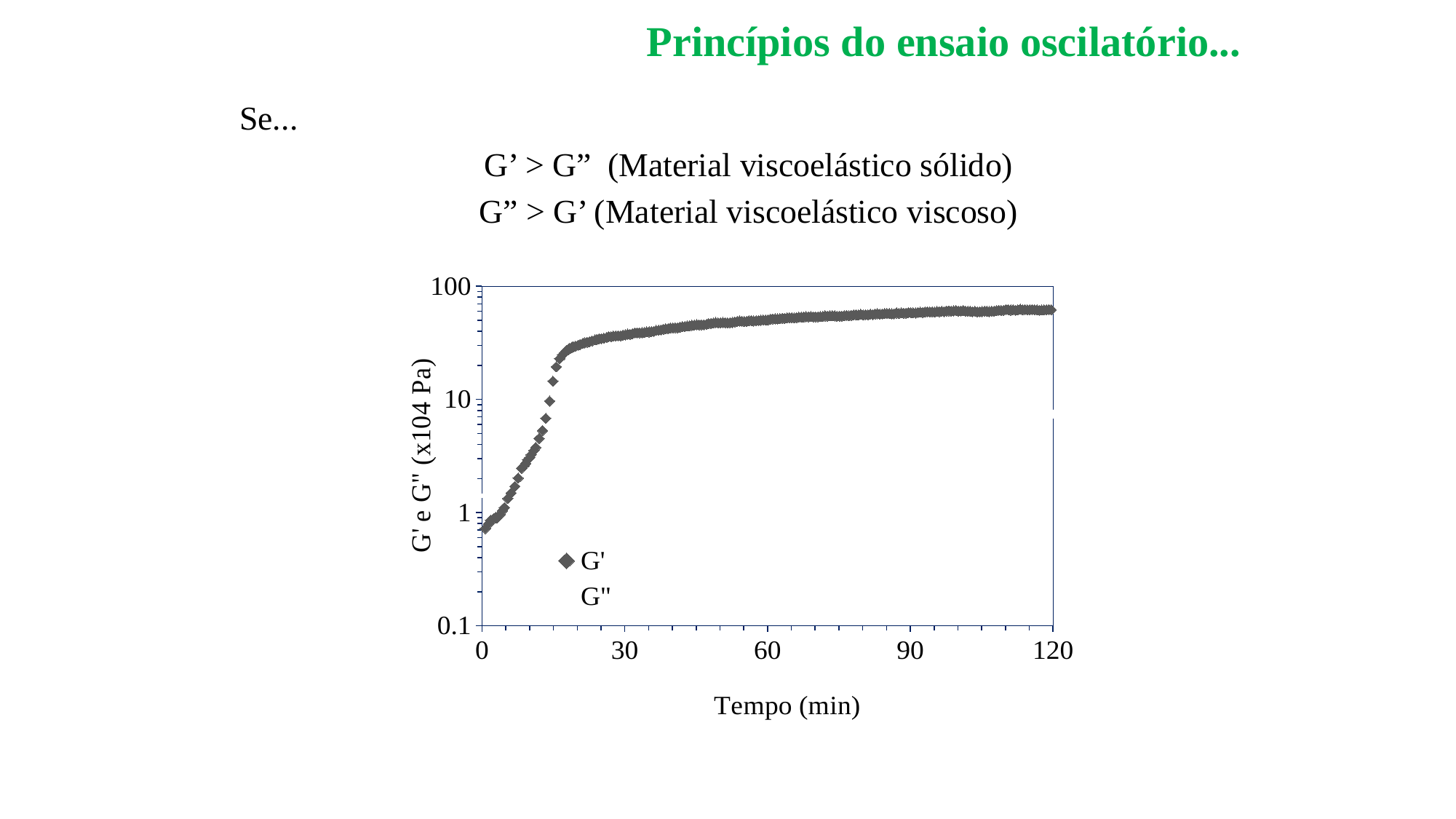
What kind of chart is shown on the slide? scatter chart Is the G' value at 30 min greater or less than 10? greater How many series does the chart legend list? 2 What is the title of the x axis of the chart? Tempo (min) Is the G' value at 10 min greater or less than 10? less Do the plotted G' values rise or fall as time increases along the x axis? rise Is the G' value at 120 min greater or less than 10? greater Which is larger, the G' value at 120 min or the G' value at 5 min? 120 min What are the two entries listed in the chart legend? G' and G"